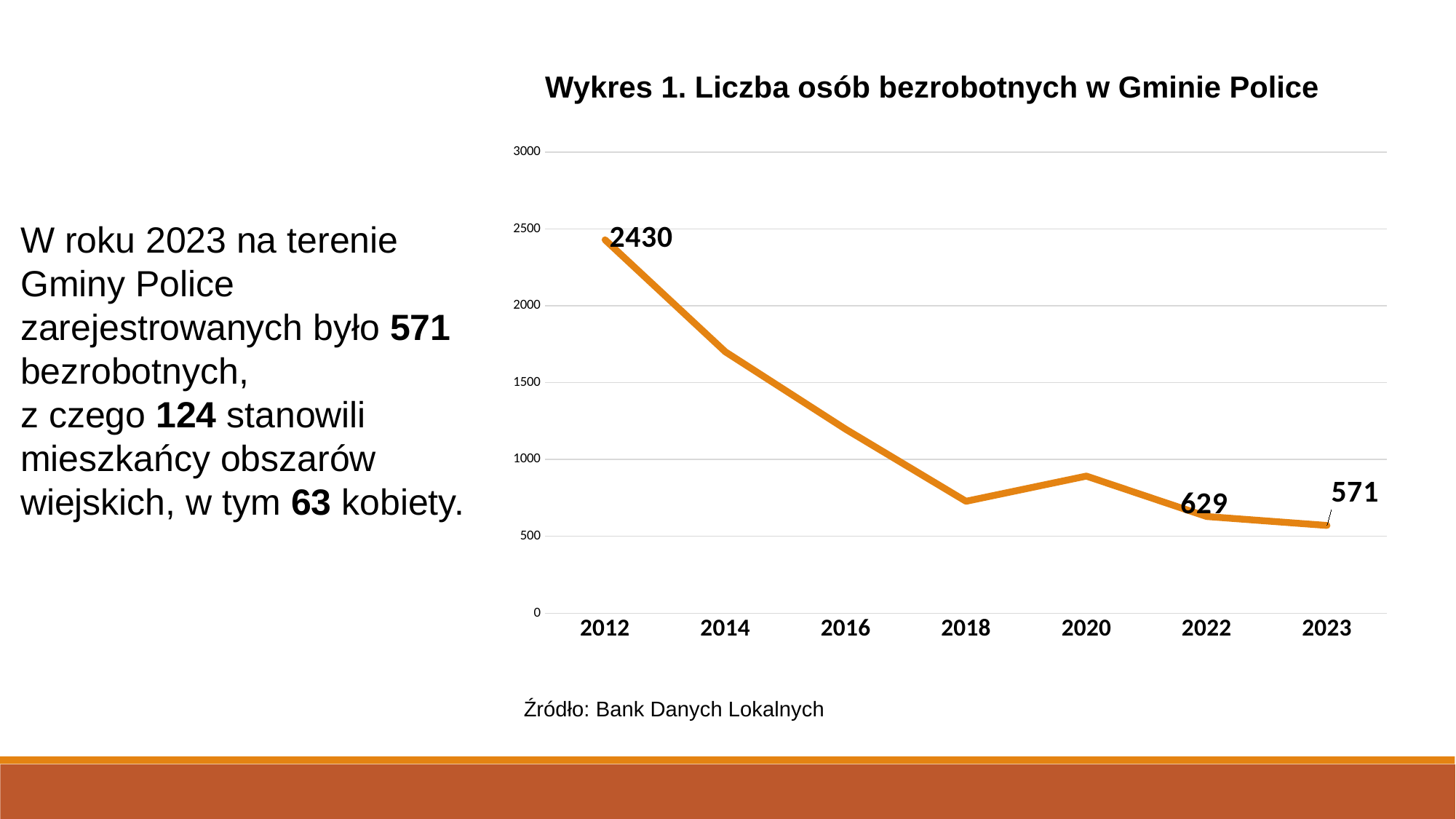
Is the value for 2014 greater or less than 1500? greater Do the values generally rise or fall from 2012 to 2023? fall Which is larger, the value for 2012 or the value for 2022? 2012 What is the value for 2023 in the chart? 571 Is the value for 2020 greater or less than 1000? less What is the value for 2012 in the chart? 2430 Which year has the highest value in the chart? 2012 How many years are shown on the x axis of the chart? 7 What is the value for 2022 in the chart? 629 Which year has the lowest value in the chart? 2023 What is the difference between the values for 2022 and 2023? 58 What kind of chart is shown on the slide? line chart